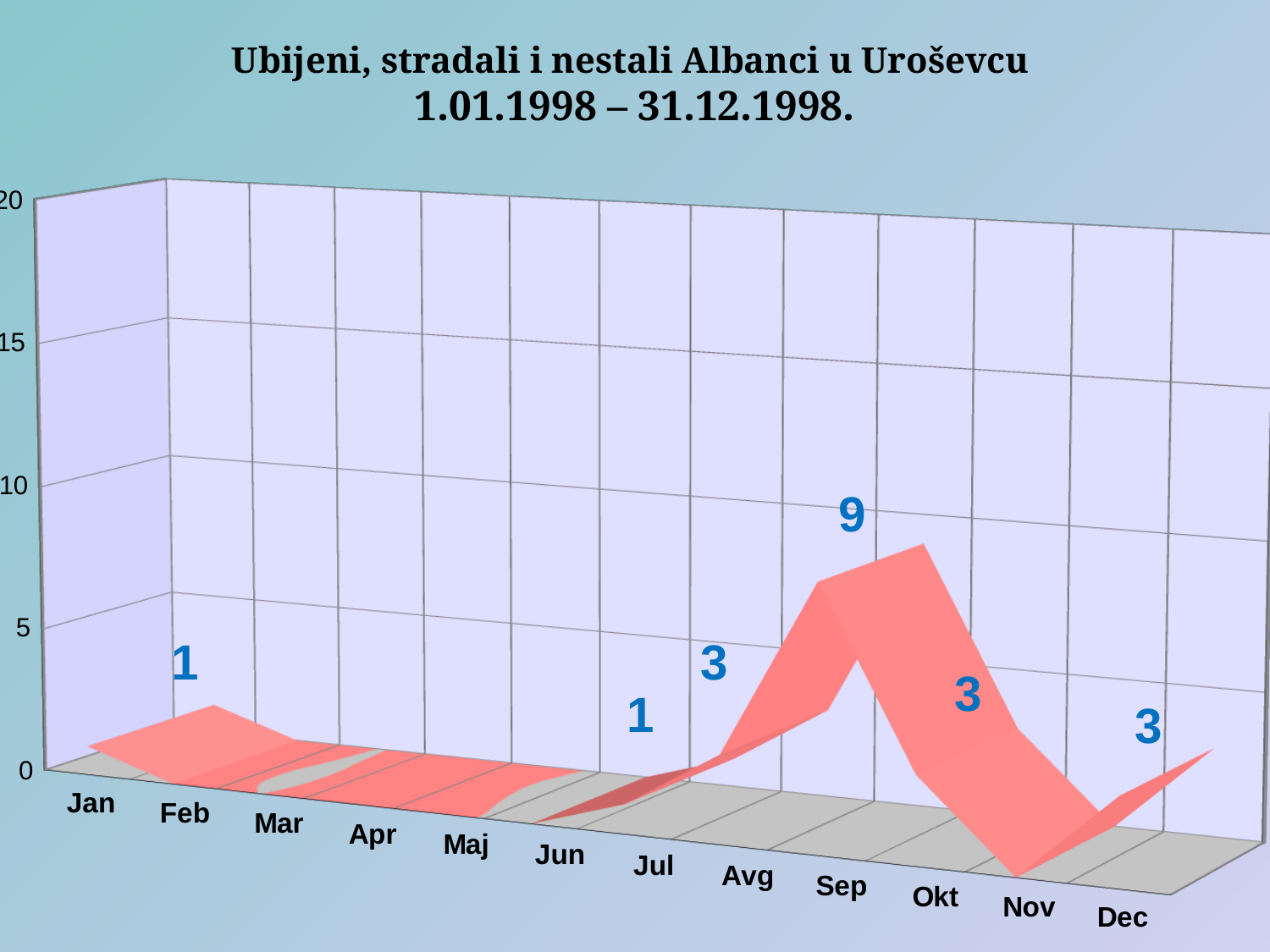
Which is larger, the value for Sep or the value for Okt? Sep Which month has the highest value? Sep What is the difference between the values for Sep and Avg? 6 What kind of chart is shown on the slide? 3D line chart What is the value for Jul? 1 What is the value for Okt? 3 How many months are shown on the x axis? 12 What is the value for Feb? 0 What is the value for Dec? 3 What is the value for Avg? 3 Is the value for Sep greater or less than 10? less What is the value for Sep? 9